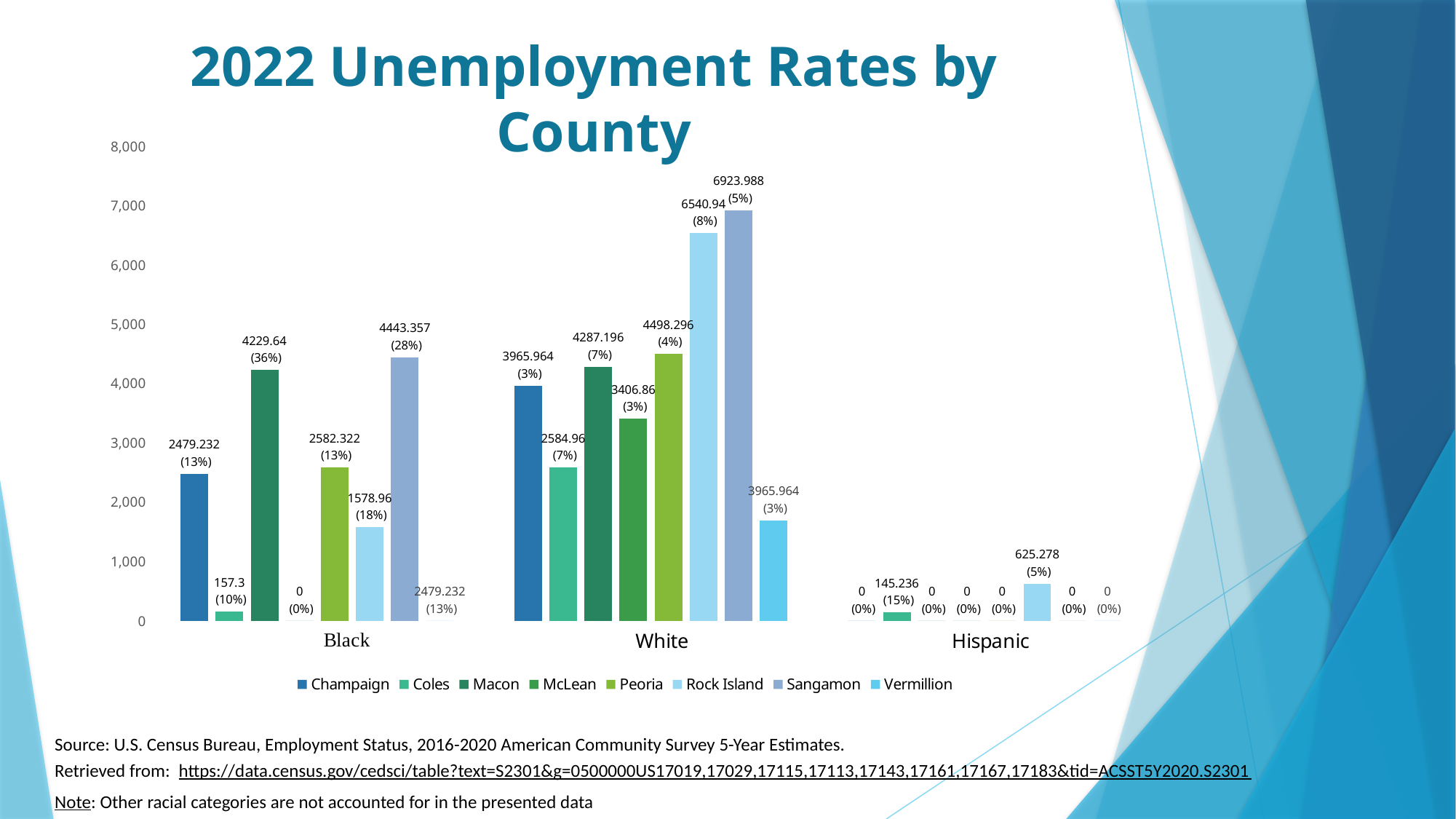
Is the value for Rock Island in the Black category greater or less than 2,000? less What is the difference between the Rock Island and Champaign values in the White category? 2574.976 What percentage is shown for Macon in the Black category? 36% What is the value for Coles in the Hispanic category? 145.236 How many series does the legend list? 8 Which county has the highest value in the Hispanic category? Rock Island What is the value for Macon in the Black category? 4229.64 In the White category, which is larger: the value for Peoria or the value for Macon? Peoria What kind of chart is shown on the slide? bar chart What is the value for Sangamon in the White category? 6923.988 Which county has the highest value in the White category? Sangamon How many racial categories are shown on the x axis? 3